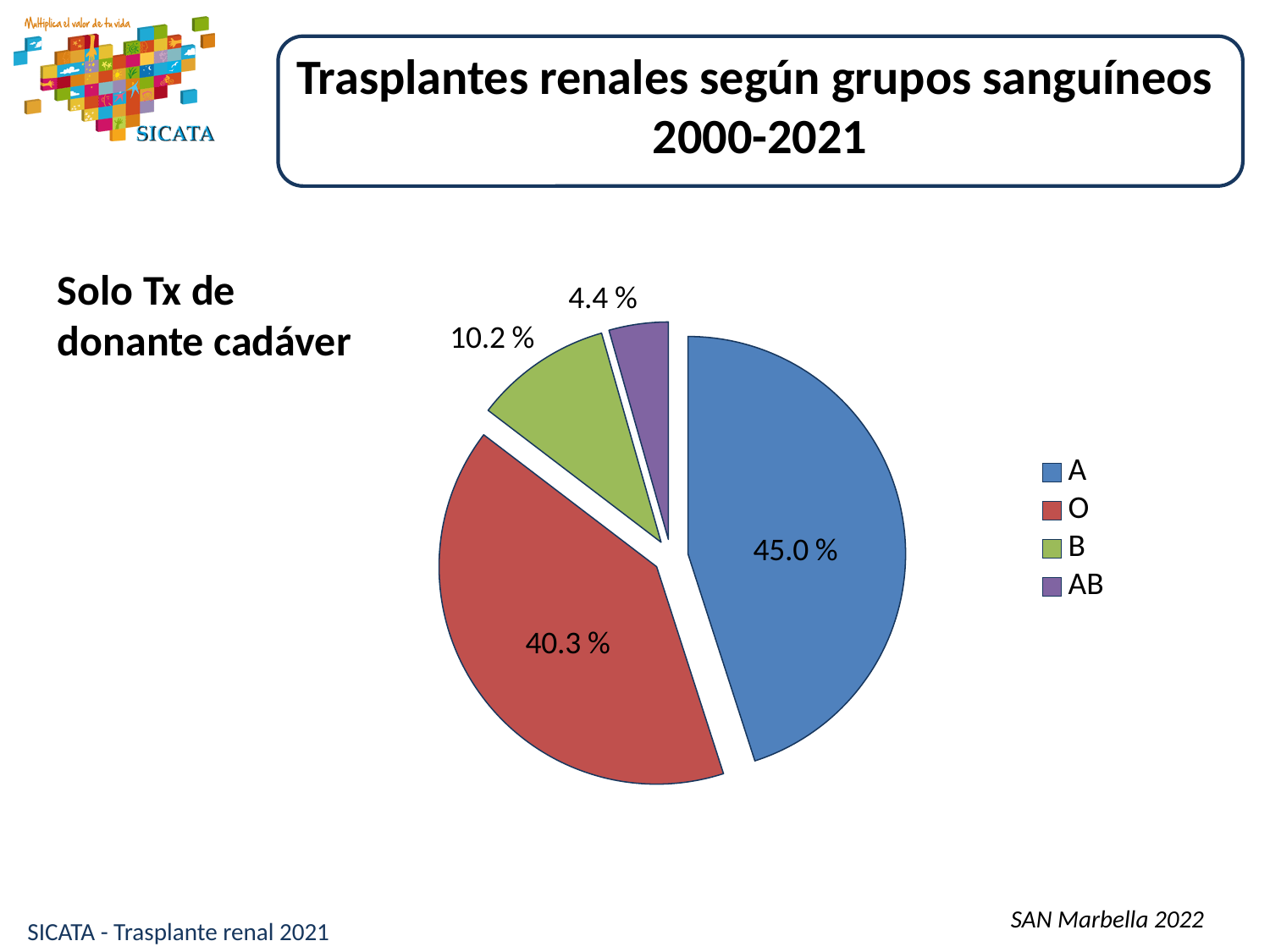
What colour is the slice for blood group O? Red What kind of chart is shown on the slide? Pie chart What share of the pie does blood group O represent? 40.3 % Which blood group has the largest slice of the pie? A What is the difference in percentage points between blood group A and blood group O? 4.7 What share of the pie does blood group B represent? 10.2 % What share of the pie does blood group A represent? 45.0 % What share of the pie does blood group AB represent? 4.4 % How many blood groups are shown in the pie chart? 4 Which is larger, the slice for blood group B or the slice for blood group AB? B Which blood group has the smallest slice of the pie? AB What is the difference in percentage points between blood group B and blood group AB? 5.8